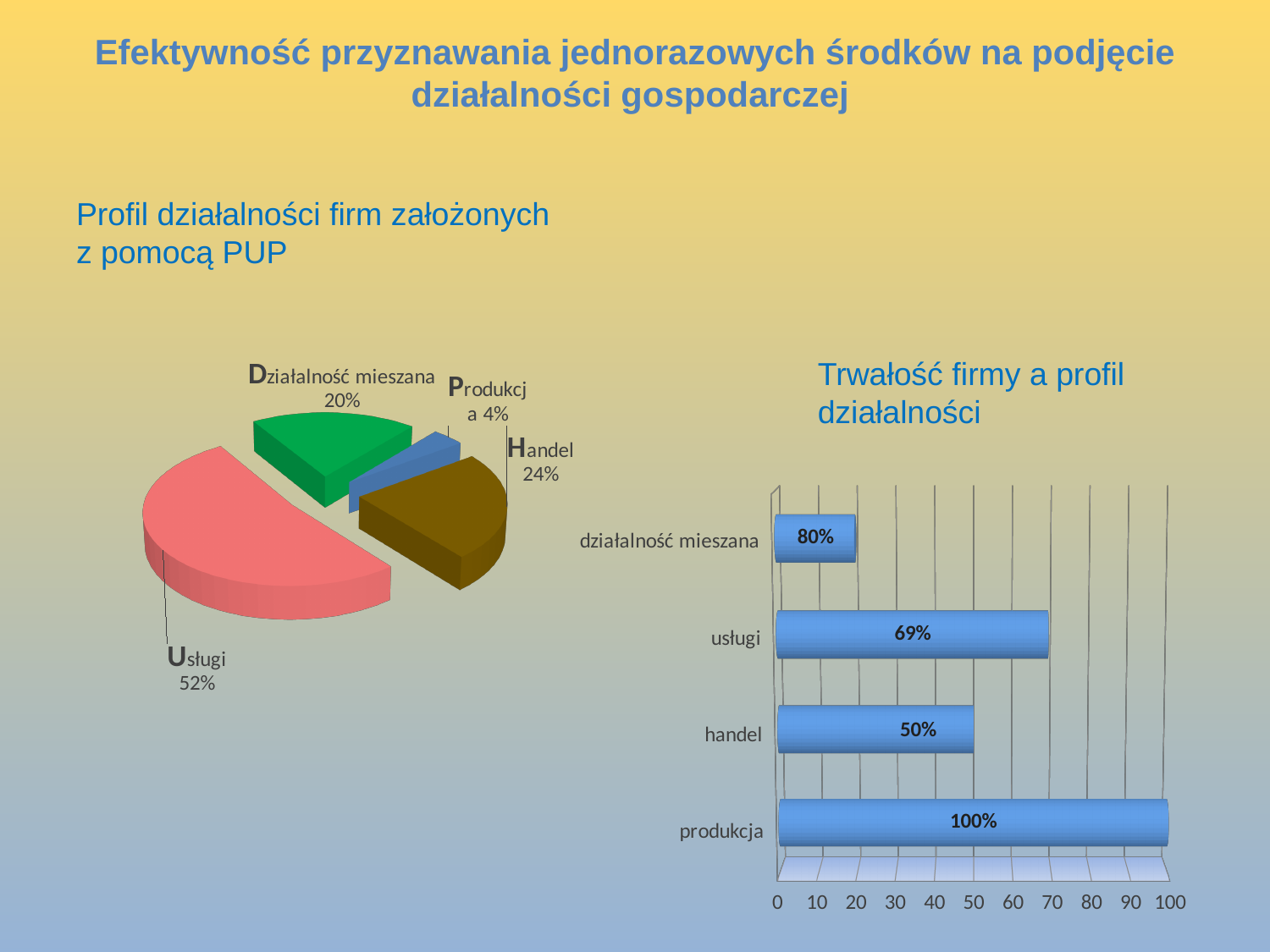
In the chart titled 'Trwałość firmy a profil działalności', what is the value for usługi? 69% In the pie chart on the left, how many slices are there? 4 In the pie chart on the left, which category has the largest share? Usługi In the pie chart on the left, what share does Handel have? 24% In the pie chart on the left, what share does Usługi have? 52% What kind of chart is the chart on the left of the slide? Pie chart In the pie chart on the left, which category has the smallest share? Produkcja In the pie chart on the left, what is the difference between the shares of Handel and Działalność mieszana? 4% In the chart titled 'Trwałość firmy a profil działalności', which category has the highest value? produkcja What kind of chart is the chart titled 'Trwałość firmy a profil działalności'? Bar chart